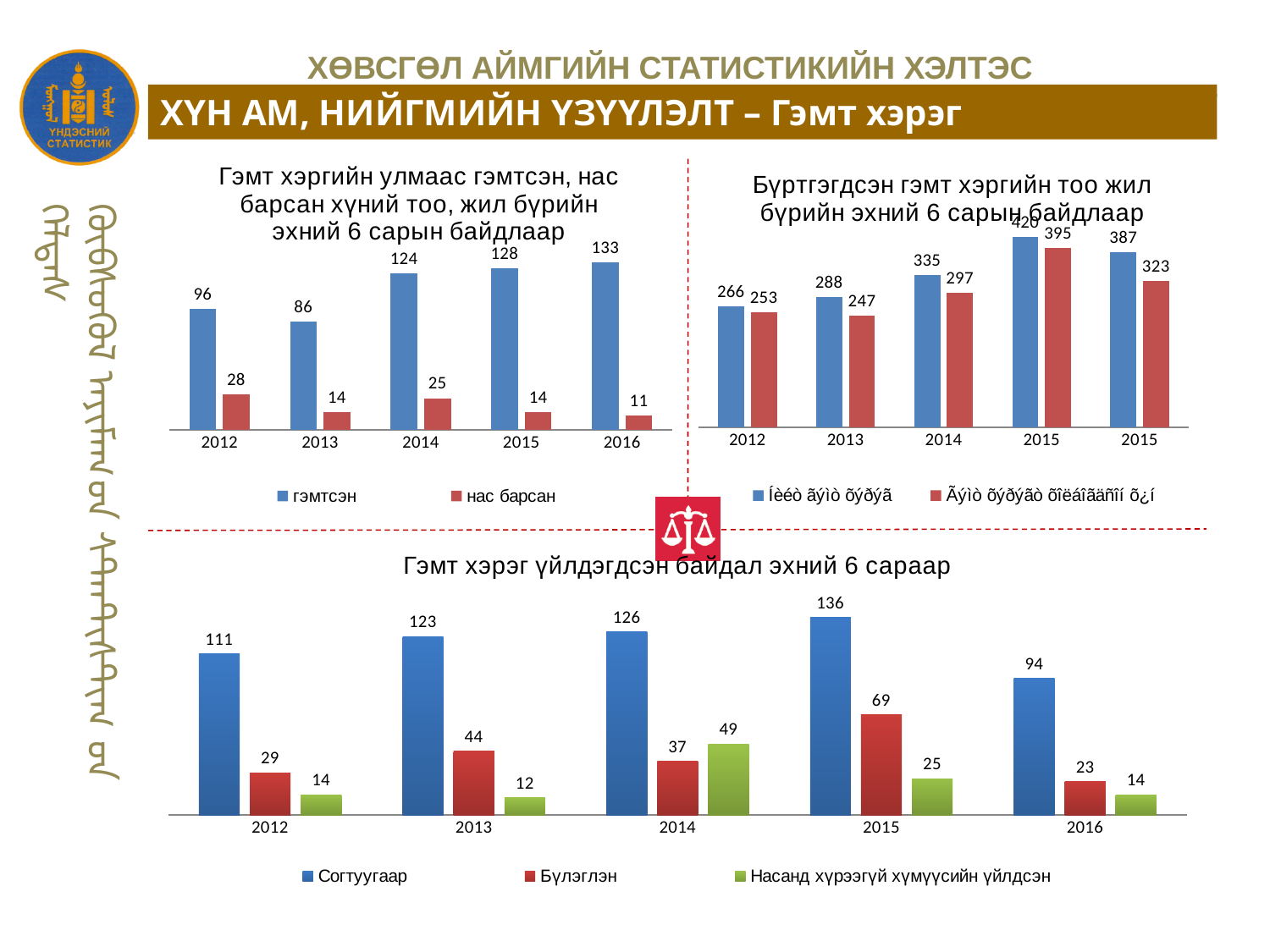
In the top-left chart (Гэмт хэргийн улмаас гэмтсэн, нас барсан хүний тоо), what is the difference between гэмтсэн and нас барсан in 2012? 68 In the top-right chart (Бүртгэгдсэн гэмт хэргийн тоо), what is the difference between the blue bar and the red bar for 2013? 41 In the top-right chart (Бүртгэгдсэн гэмт хэргийн тоо), what is the highest value shown on any bar? 420 What kind of chart is the bottom chart (Гэмт хэрэг үйлдэгдсэн байдал эхний 6 сараар)? Bar chart In the top-left chart (Гэмт хэргийн улмаас гэмтсэн, нас барсан хүний тоо), how many series does the legend list? 2 In the bottom chart (Гэмт хэрэг үйлдэгдсэн байдал эхний 6 сараар), what is the value for Бүлэглэн in 2015? 69 In the top-left chart (Гэмт хэргийн улмаас гэмтсэн, нас барсан хүний тоо), what is the value for гэмтсэн in 2014? 124 In the bottom chart (Гэмт хэрэг үйлдэгдсэн байдал эхний 6 сараар), how many years are shown on the x axis? 5 In the top-right chart (Бүртгэгдсэн гэмт хэргийн тоо), what is the value of the blue bar for 2014? 335 In the top-left chart (Гэмт хэргийн улмаас гэмтсэн, нас барсан хүний тоо), which year has the lowest value for нас барсан? 2016 In the bottom chart (Гэмт хэрэг үйлдэгдсэн байдал эхний 6 сараар), which is larger in 2014: Бүлэглэн or Насанд хүрээгүй хүмүүсийн үйлдсэн? Насанд хүрээгүй хүмүүсийн үйлдсэн In the bottom chart (Гэмт хэрэг үйлдэгдсэн байдал эхний 6 сараар), which year has the highest value for Согтуугаар? 2015